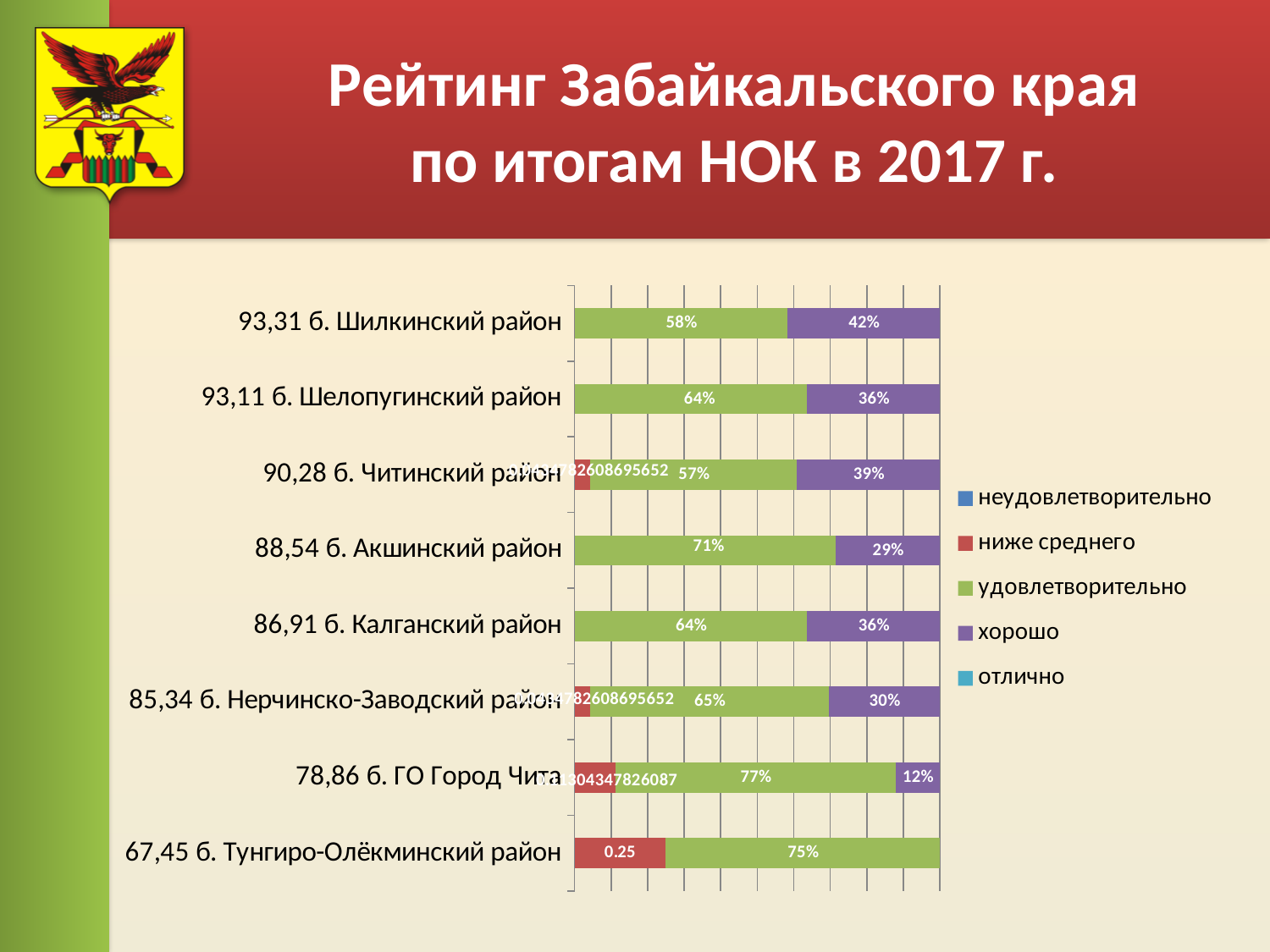
Which district has the highest 'удовлетворительно' value? 78,86 б. ГО Город Чита What is the 'хорошо' value for 93,11 б. Шелопугинский район? 36% What is the 'удовлетворительно' value for 67,45 б. Тунгиро-Олёкминский район? 75% Which is larger: the 'удовлетворительно' value for 88,54 б. Акшинский район or for 86,91 б. Калганский район? 88,54 б. Акшинский район What is the 'хорошо' value for 78,86 б. ГО Город Чита? 12% What kind of chart is shown on the slide? Stacked bar chart Which district has the highest 'хорошо' value? 93,31 б. Шилкинский район What is the difference between the 'удовлетворительно' and 'хорошо' values for 93,31 б. Шилкинский район? 16 percentage points How many series does the legend list? 5 How many districts (categories) are plotted in the chart? 8 What is the 'удовлетворительно' value for 88,54 б. Акшинский район? 71% What is the 'удовлетворительно' value for 93,31 б. Шилкинский район? 58%